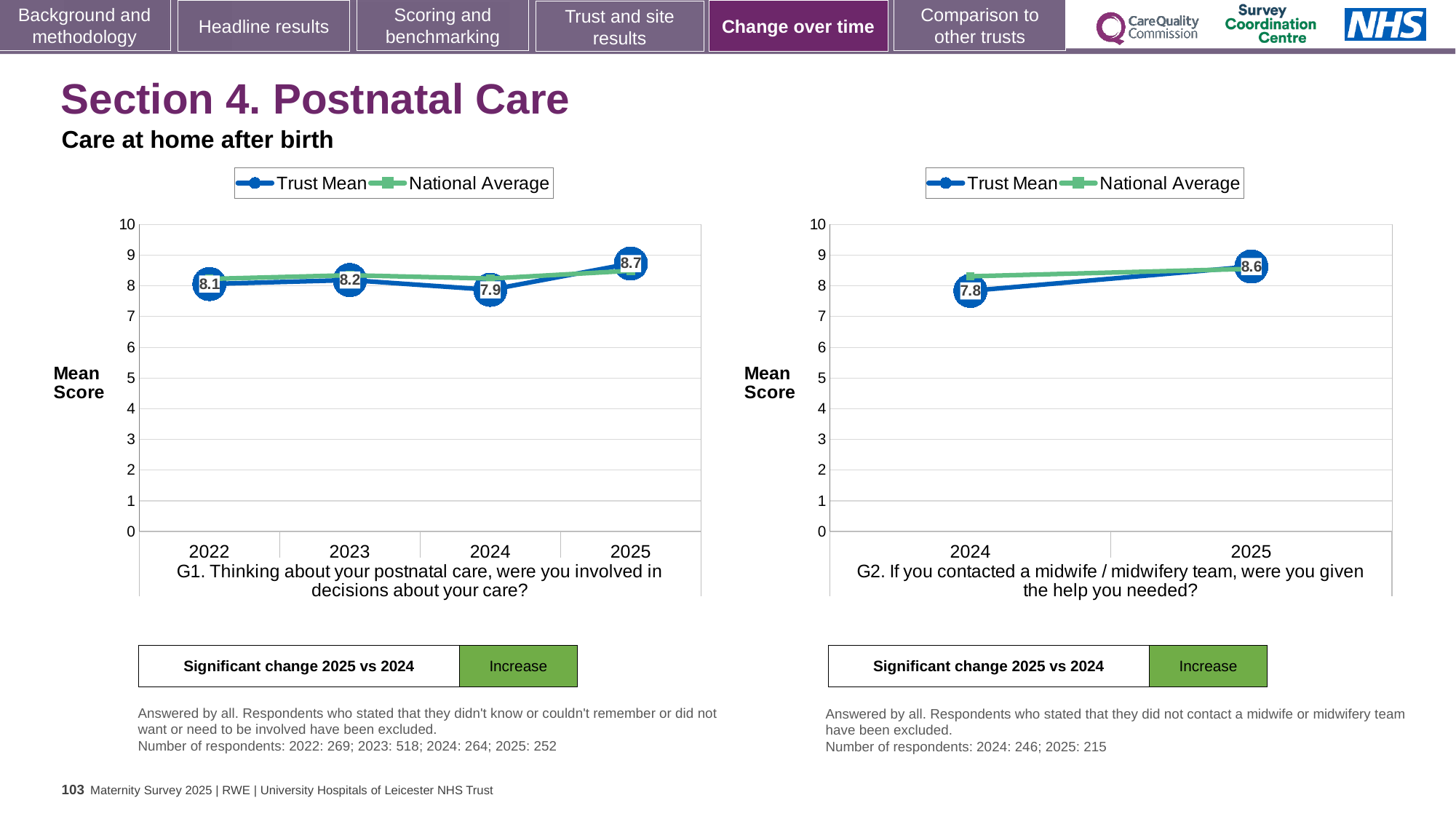
In the left chart (G1), is the Trust Mean score for 2023 higher or lower than for 2022? higher How many series does the legend of the right chart (G2) list? 2 In the left chart (G1), which year has the lowest Trust Mean score? 2024 In the right chart (G2), is the Trust Mean value for 2024 greater or less than 8? less In the left chart (G1), what is the Trust Mean score for 2025? 8.7 How many years are plotted on the x axis of the left chart (G1)? 4 In the right chart (G2), what is the difference between the Trust Mean scores for 2025 and 2024? 0.8 In the left chart (G1), what is the Trust Mean score for 2024? 7.9 In the right chart (G2), what is the Trust Mean score for 2024? 7.8 In the left chart (G1), which year has the highest Trust Mean score? 2025 What type of chart is the right chart (G2)? line chart In the left chart (G1), what is the difference between the Trust Mean scores for 2025 and 2024? 0.8